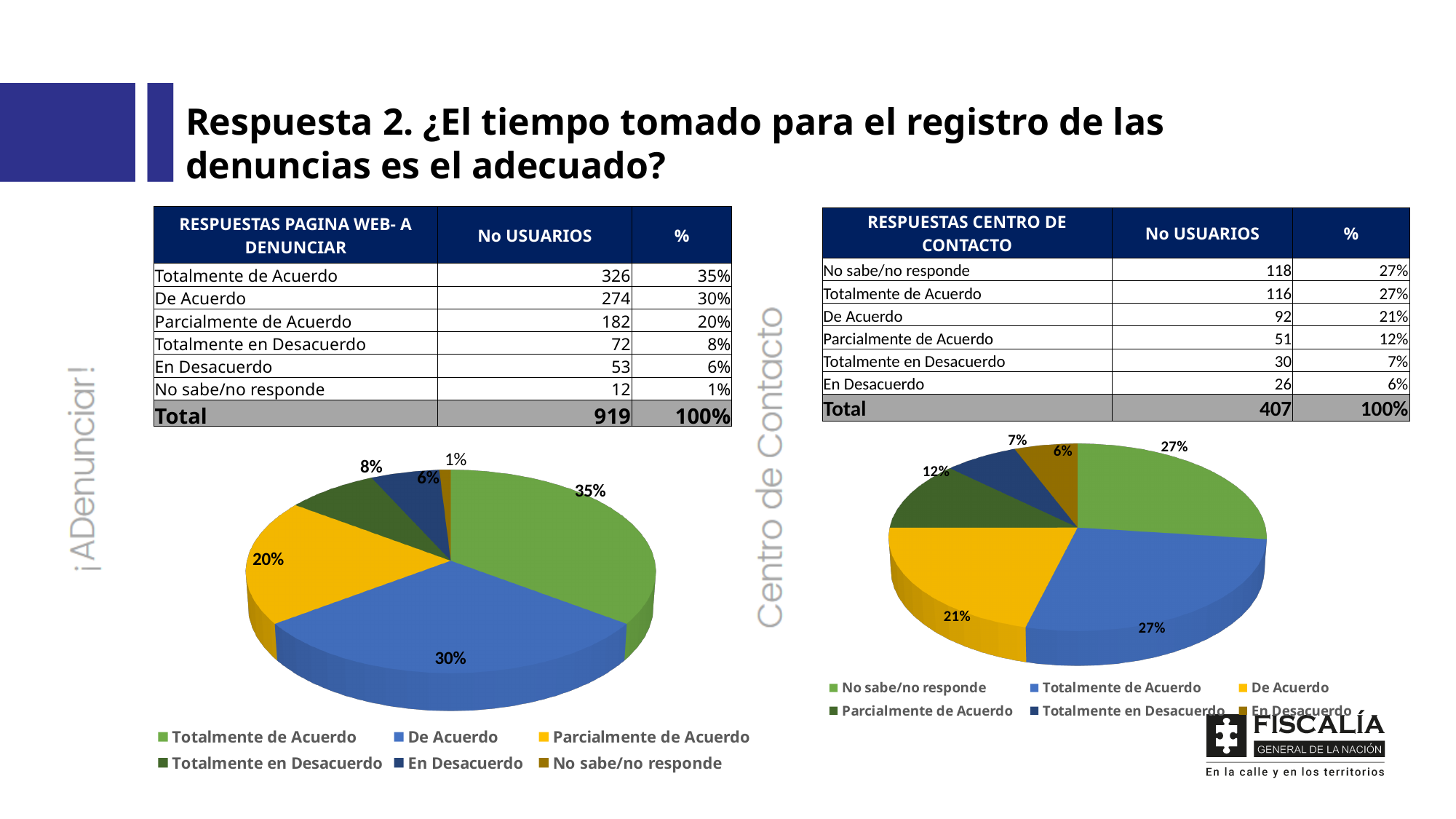
How many entries does the legend of the right pie chart (Centro de Contacto) list? 6 In the right pie chart (Centro de Contacto), which category has the smallest slice? En Desacuerdo In the left pie chart (Página Web - ADenunciar), which category has the largest slice? Totalmente de Acuerdo In the left pie chart (Página Web - ADenunciar), which category has the smallest slice? No sabe/no responde In the right pie chart (Centro de Contacto), which is larger: 'Parcialmente de Acuerdo' or 'Totalmente en Desacuerdo'? Parcialmente de Acuerdo In the right pie chart (Centro de Contacto), what share does the 'De Acuerdo' slice have? 21% What kind of chart is the left chart (Página Web - ADenunciar)? Pie chart How many slices does the left pie chart (Página Web - ADenunciar) have? 6 In the left pie chart (Página Web - ADenunciar), what share does 'Totalmente en Desacuerdo' have? 8% In the left pie chart (Página Web - ADenunciar), what share does the 'Totalmente de Acuerdo' slice have? 35% In the right pie chart (Centro de Contacto), what share does 'Totalmente en Desacuerdo' have? 7% In the left pie chart (Página Web - ADenunciar), what is the difference in percentage points between 'De Acuerdo' and 'Parcialmente de Acuerdo'? 10 percentage points